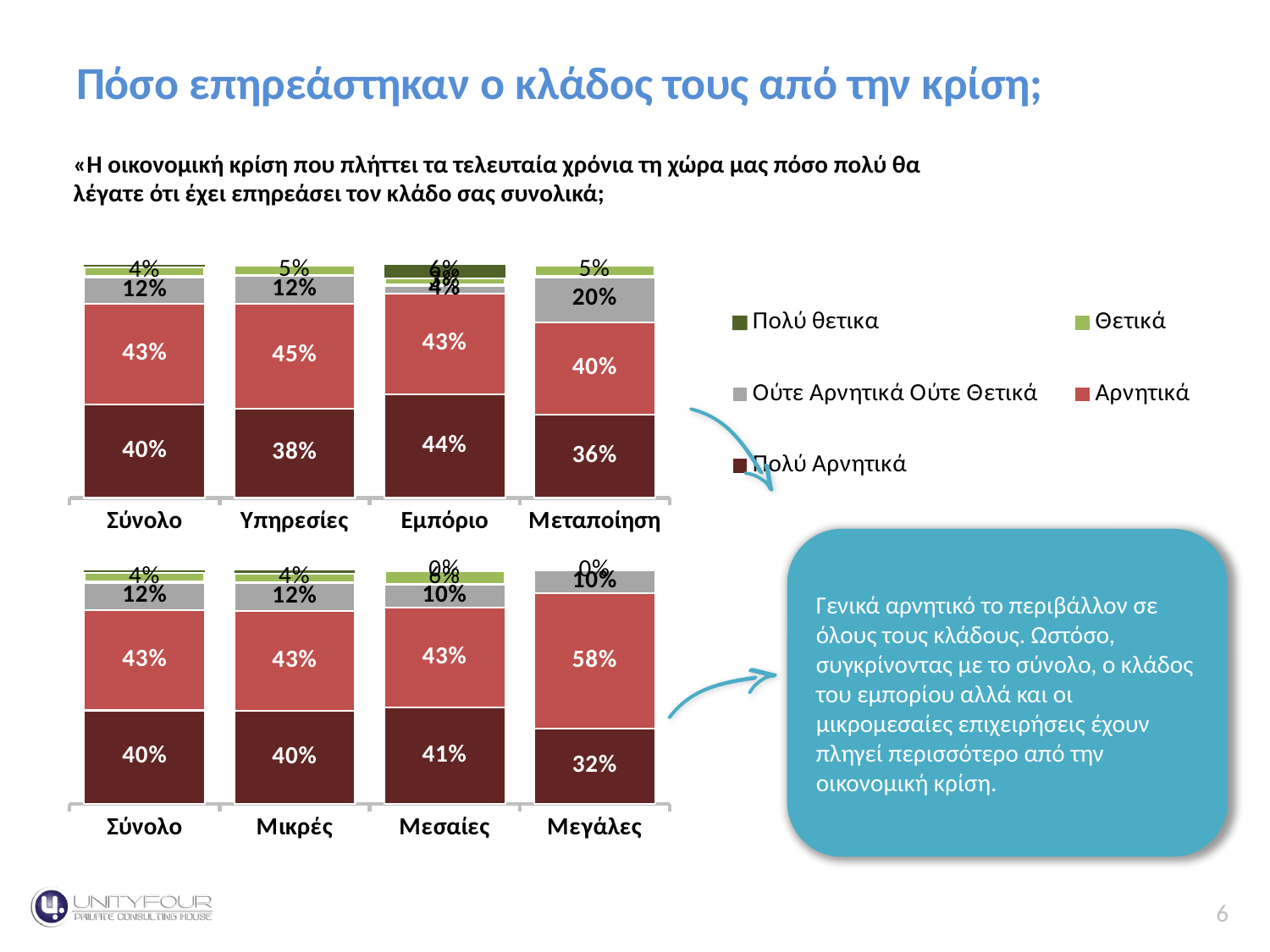
In the top chart, what is the Ούτε Αρνητικά Ούτε Θετικά value for Μεταποίηση? 20% In the top chart, what is the Πολύ Αρνητικά value for Εμπόριο? 44% In the bottom chart, what is the Αρνητικά value for Μεγάλες? 58% How many series does the legend list? 5 In the bottom chart, which category has the lowest Πολύ Αρνητικά value? Μεγάλες In the bottom chart, what is the Πολύ Αρνητικά value for Μεσαίες? 41% In the top chart, what is the difference between the Ούτε Αρνητικά Ούτε Θετικά values for Μεταποίηση and Σύνολο? 8% In the bottom chart, is the Αρνητικά value larger for Μεγάλες or for Μικρές? Μεγάλες What kind of chart is the top chart? Stacked bar chart How many categories are shown in the bottom chart? 4 In the top chart, which category has the highest Πολύ Αρνητικά value? Εμπόριο In the top chart, what is the Αρνητικά value for Υπηρεσίες? 45%